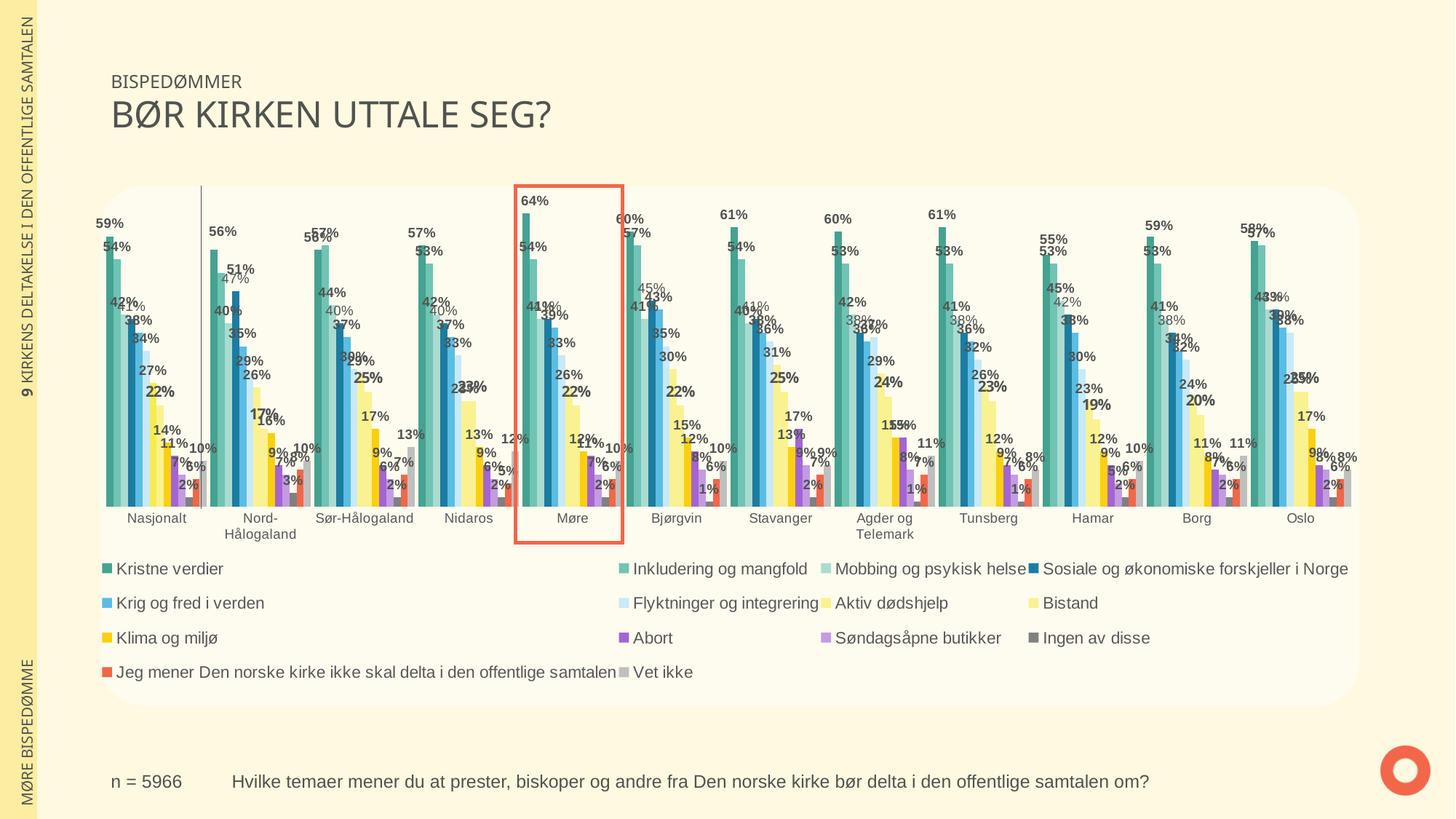
What is the value for Kristne verdier in Møre? 64% What kind of chart is shown on the slide? bar chart What is the value for Kristne verdier in Hamar? 55% Which category is highlighted with a red box on the chart? Møre Which category has the lowest value for Kristne verdier? Hamar Which category has the highest value for Kristne verdier? Møre What is the value for Inkludering og mangfold in Nasjonalt? 54% What is the difference between the Kristne verdier values for Møre and Hamar? 9 percentage points What is the value for Kristne verdier in Nasjonalt? 59% How many bispedømme categories (including Nasjonalt) are shown along the x axis? 12 How many series does the legend list? 14 Which is larger, the Kristne verdier value for Møre or for Nasjonalt? Møre